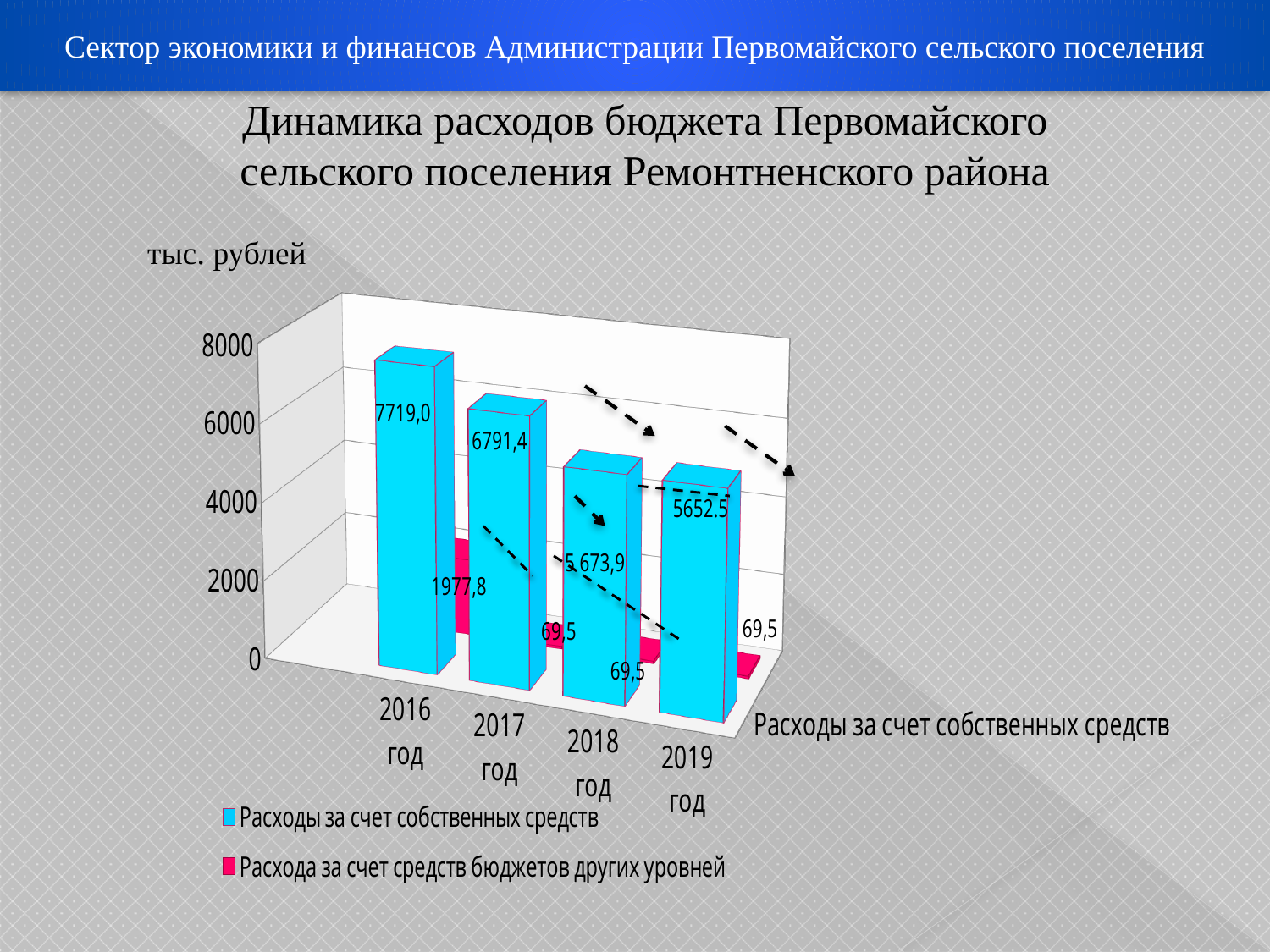
What is the value of 'Расхода за счет средств бюджетов других уровней' for 2016 год? 1977,8 In which year is 'Расходы за счет собственных средств' the lowest? 2019 год What is the value of 'Расходы за счет собственных средств' for 2016 год? 7719,0 How many series does the legend list? 2 What kind of chart is shown on the slide? bar chart Do the values of 'Расходы за счет собственных средств' rise or fall from 2016 to 2019? fall What is the difference between 'Расходы за счет собственных средств' in 2016 год and 2017 год? 927,6 What is the value of 'Расходы за счет собственных средств' for 2019 год? 5652.5 How many years are shown on the x axis? 4 In which year is 'Расходы за счет собственных средств' the highest? 2016 год What is the value of 'Расходы за счет собственных средств' for 2017 год? 6791,4 What is the value of 'Расхода за счет средств бюджетов других уровней' for 2018 год? 69,5